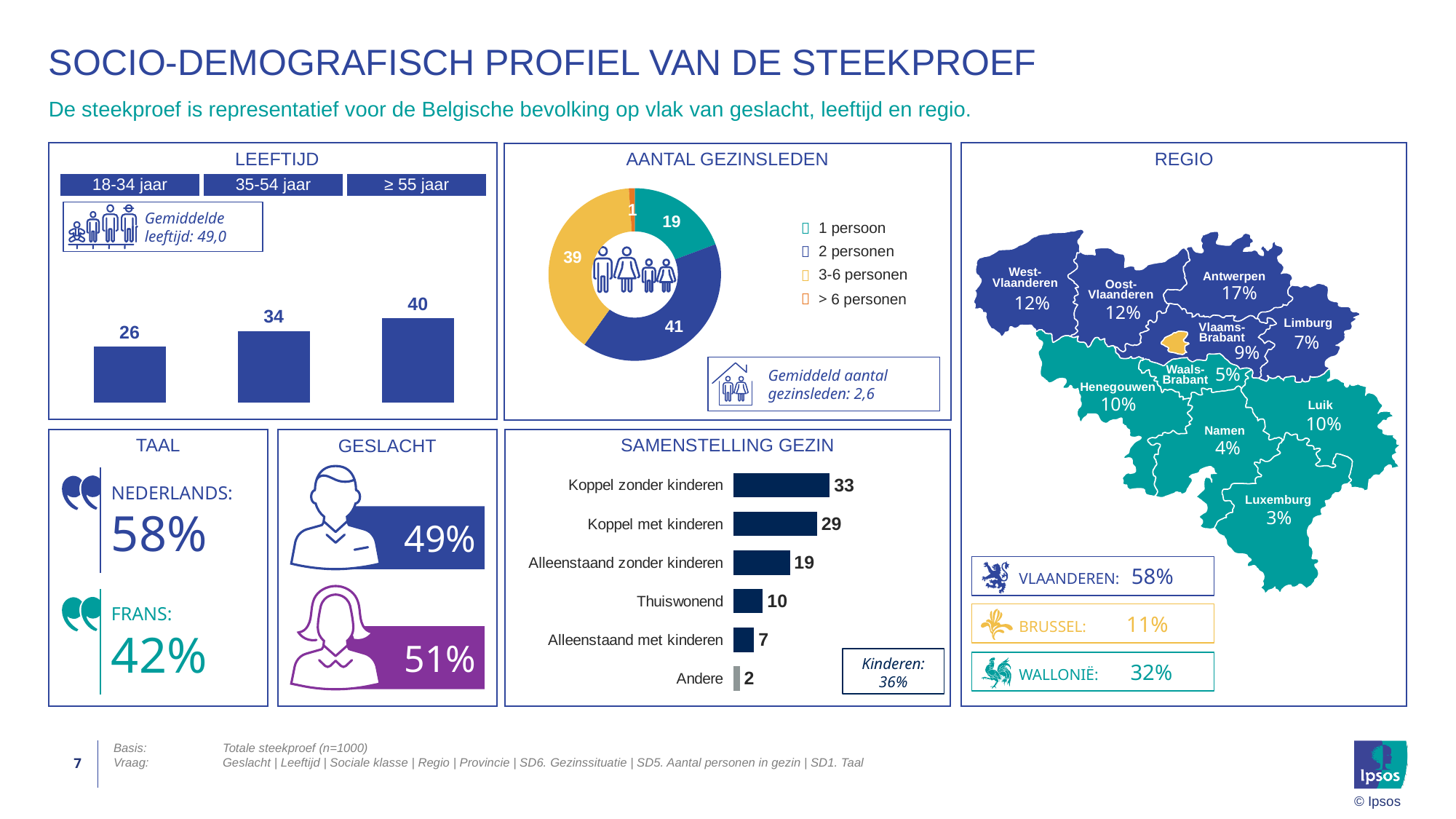
In the LEEFTIJD chart, do the values rise or fall from left to right across the age categories? rise How many series does the legend of the AANTAL GEZINSLEDEN chart list? 4 In the AANTAL GEZINSLEDEN chart, which category has the smallest value? > 6 personen In the AANTAL GEZINSLEDEN chart, what is the value for 2 personen? 41 In the LEEFTIJD chart, what is the difference between the ≥ 55 jaar and 18-34 jaar values? 14 In the SAMENSTELLING GEZIN chart, which is larger: Thuiswonend or Alleenstaand met kinderen? Thuiswonend What kind of chart is the AANTAL GEZINSLEDEN chart? donut chart In the LEEFTIJD chart, what is the value for the 35-54 jaar category? 34 In the SAMENSTELLING GEZIN chart, what is the value for Koppel met kinderen? 29 In the SAMENSTELLING GEZIN chart, how many categories are shown? 6 In the SAMENSTELLING GEZIN chart, which category has the highest value? Koppel zonder kinderen In the LEEFTIJD chart, which age category has the highest value? ≥ 55 jaar